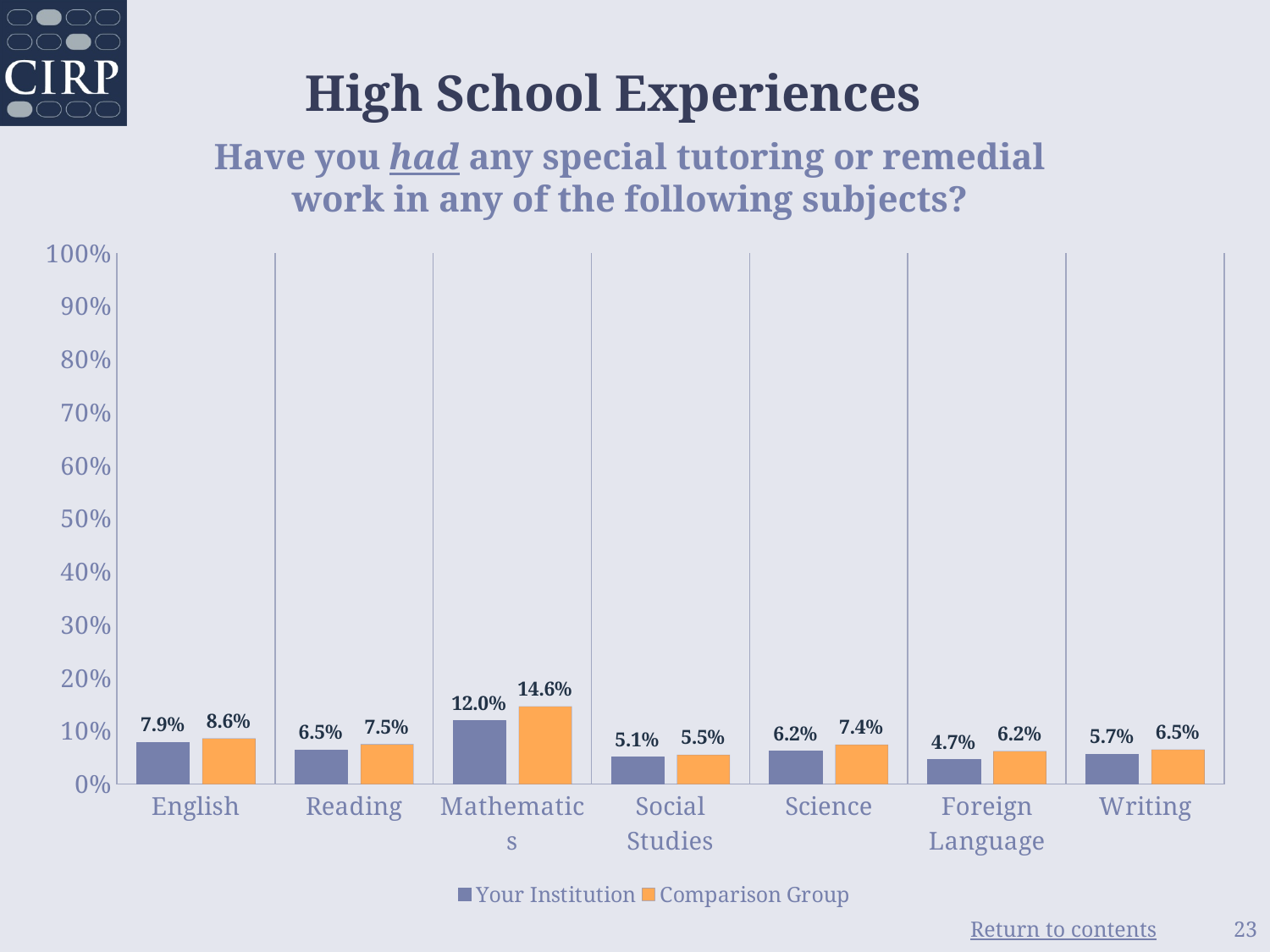
Which subject has the highest value for Comparison Group? Mathematics Which subject has the lowest value for Your Institution? Foreign Language What is the value for Your Institution in Social Studies? 5.1% Which series is shown in orange? Comparison Group What kind of chart is shown on the slide? bar chart Which is larger in Science: Your Institution or Comparison Group? Comparison Group What is the value for Your Institution in Mathematics? 12.0% Is the value for Comparison Group in Mathematics greater or less than 10%? greater What is the difference between Comparison Group and Your Institution in Mathematics? 2.6% How many subjects are shown on the x axis? 7 What is the value for Comparison Group in Foreign Language? 6.2% How many series does the legend list? 2